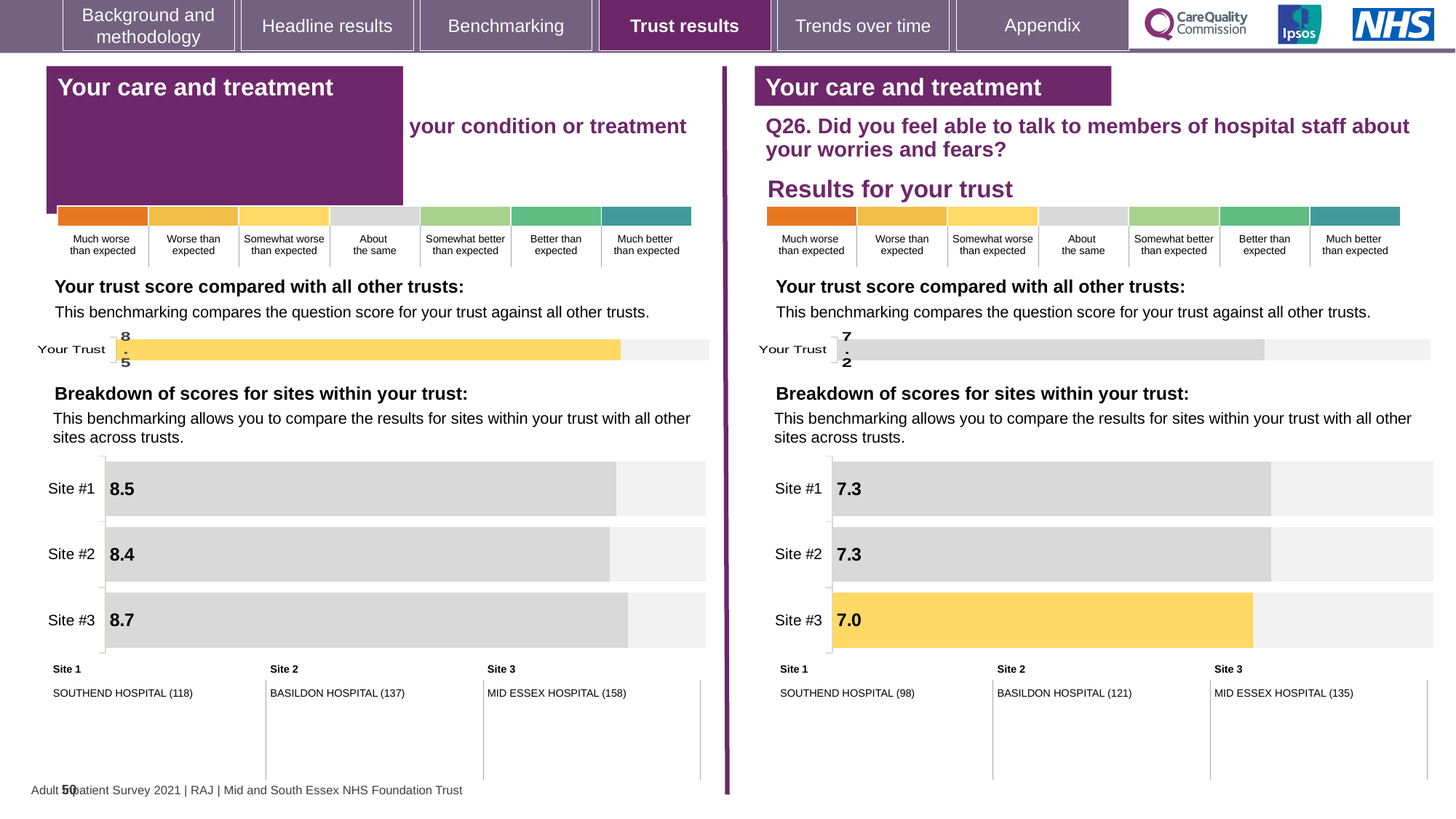
On the right-hand Q26 'Breakdown of scores for sites within your trust' chart, what is the score for Site #3? 7.0 On the left-hand site breakdown chart, what is the difference between the scores for Site #3 and Site #2? 0.3 On the left-hand site breakdown chart, which site has the highest score? Site #3 What type of chart is the right-hand Q26 site breakdown chart? Bar chart On the right-hand Q26 'Your trust score compared with all other trusts' chart, what is the score for Your Trust? 7.2 On the right-hand Q26 site breakdown chart, which site has the lowest score? Site #3 On the right-hand Q26 site breakdown chart, what is the difference between the scores for Site #1 and Site #3? 0.3 On the left-hand 'Breakdown of scores for sites within your trust' chart, what is the score for Site #1? 8.5 On the left-hand site breakdown chart, which site has the lowest score? Site #2 On the right-hand Q26 site breakdown chart, what is the score for Site #1? 7.3 How many sites are shown on the left-hand site breakdown chart? 3 On the left-hand 'Breakdown of scores for sites within your trust' chart, what is the score for Site #3? 8.7